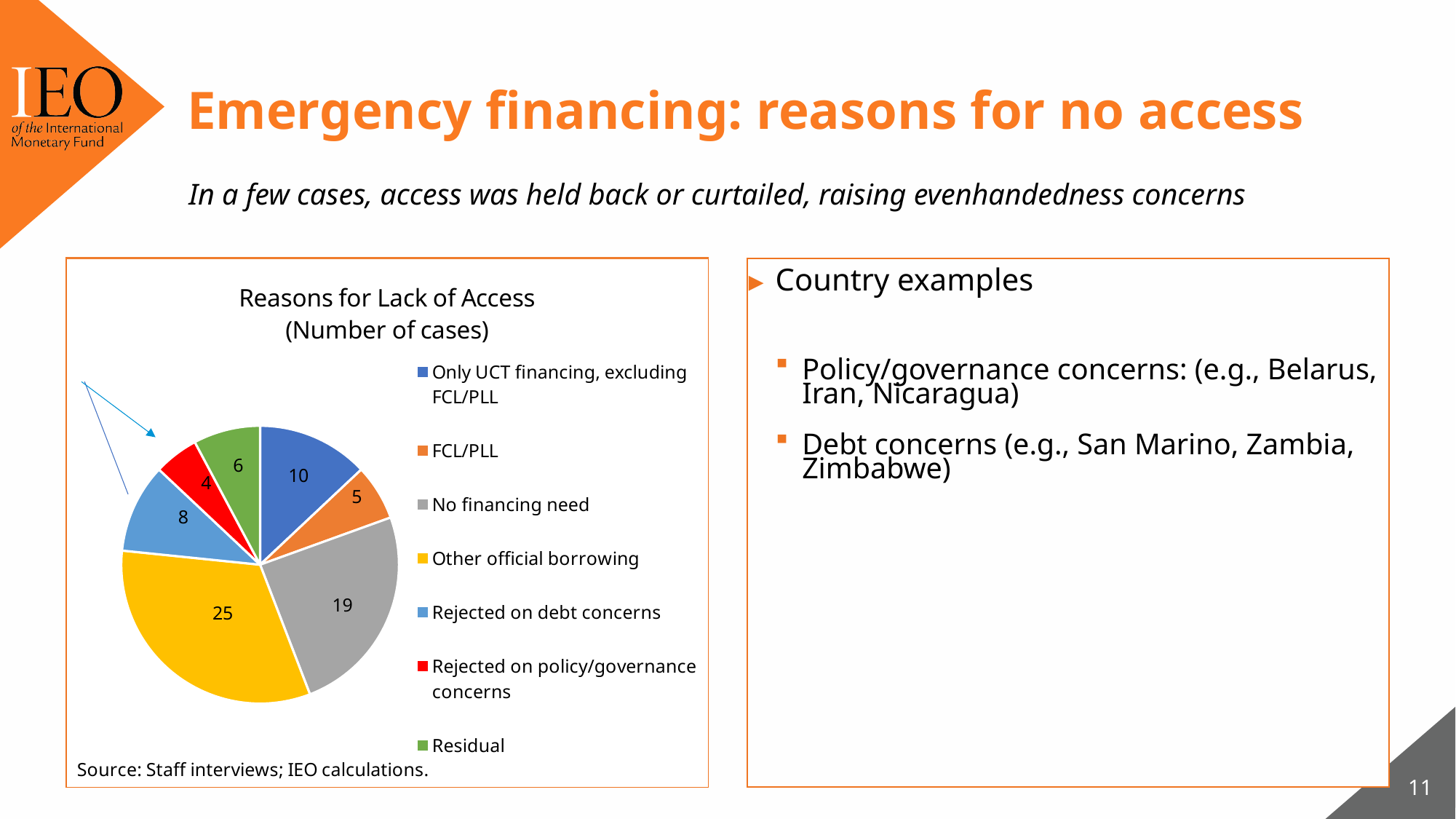
What kind of chart is shown on the slide? Pie chart Which reason accounts for the smallest number of cases? Rejected on policy/governance concerns Which reason accounts for the largest number of cases? Other official borrowing How many cases were 'Rejected on debt concerns'? 8 How many cases are attributed to 'Other official borrowing'? 25 How many cases were 'Rejected on policy/governance concerns'? 4 What is the title of the chart? Reasons for Lack of Access (Number of cases) How many categories does the legend of the pie chart list? 7 How many cases are attributed to 'No financing need'? 19 Which has more cases: 'FCL/PLL' or 'Residual'? Residual How many cases fall under 'Only UCT financing, excluding FCL/PLL'? 10 What is the difference in the number of cases between 'Other official borrowing' and 'No financing need'? 6